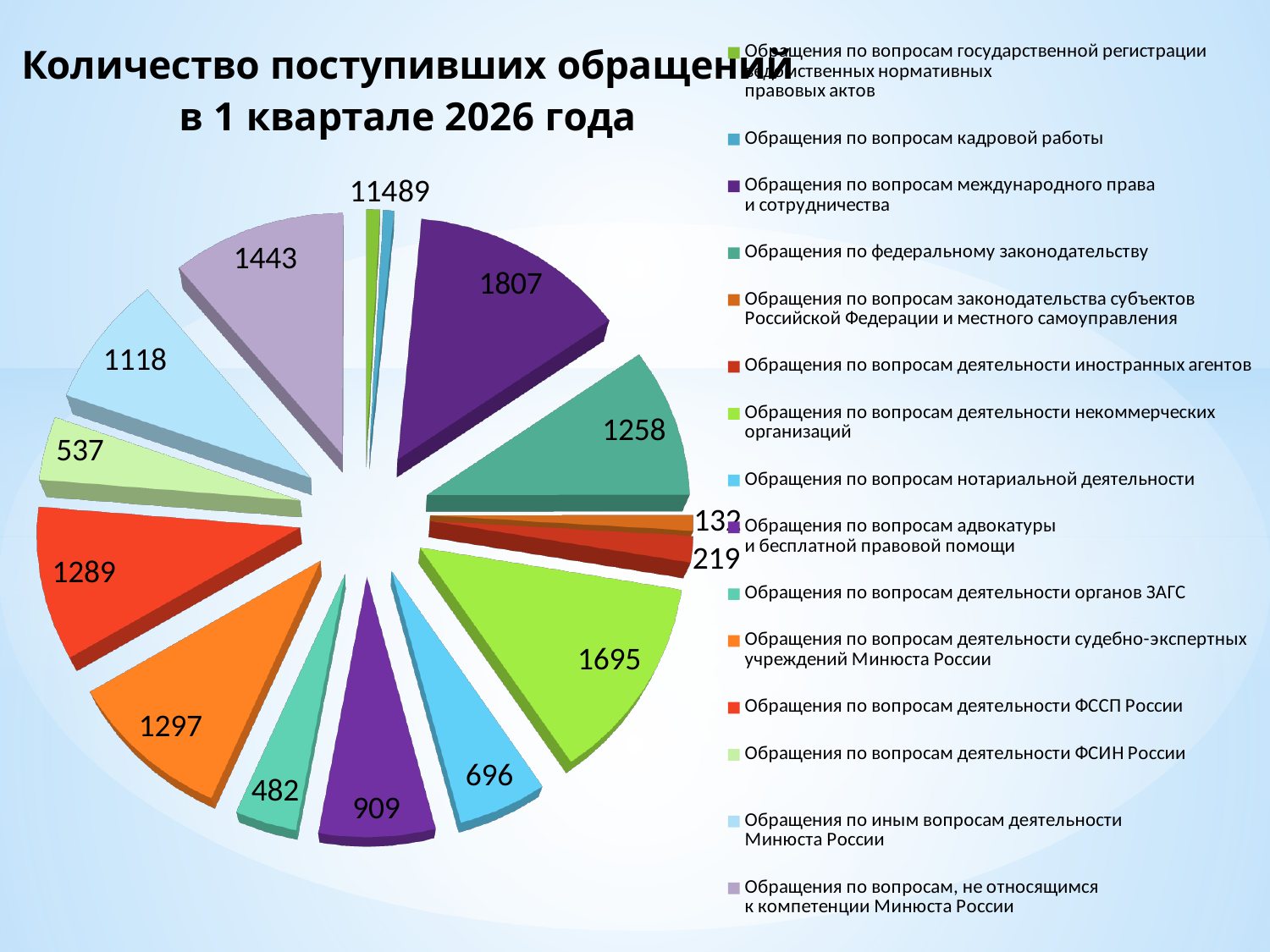
What type of chart is shown on the slide? pie chart Which is larger: the value for «Обращения по вопросам деятельности ФСИН России» or for «Обращения по иным вопросам деятельности Минюста России»? Обращения по иным вопросам деятельности Минюста России What is the difference between the values for «Обращения по вопросам международного права и сотрудничества» and «Обращения по федеральному законодательству»? 549 What is the value for «Обращения по вопросам, не относящимся к компетенции Минюста России»? 1443 What is the value for «Обращения по вопросам нотариальной деятельности»? 696 What is the title of the chart? Количество поступивших обращений в 1 квартале 2026 года What is the value for «Обращения по федеральному законодательству»? 1258 Which category has the highest value? Обращения по вопросам международного права и сотрудничества What is the value for «Обращения по вопросам деятельности органов ЗАГС»? 482 What is the value for «Обращения по вопросам деятельности некоммерческих организаций»? 1695 How many categories does the legend list? 15 What is the value for «Обращения по вопросам международного права и сотрудничества»? 1807